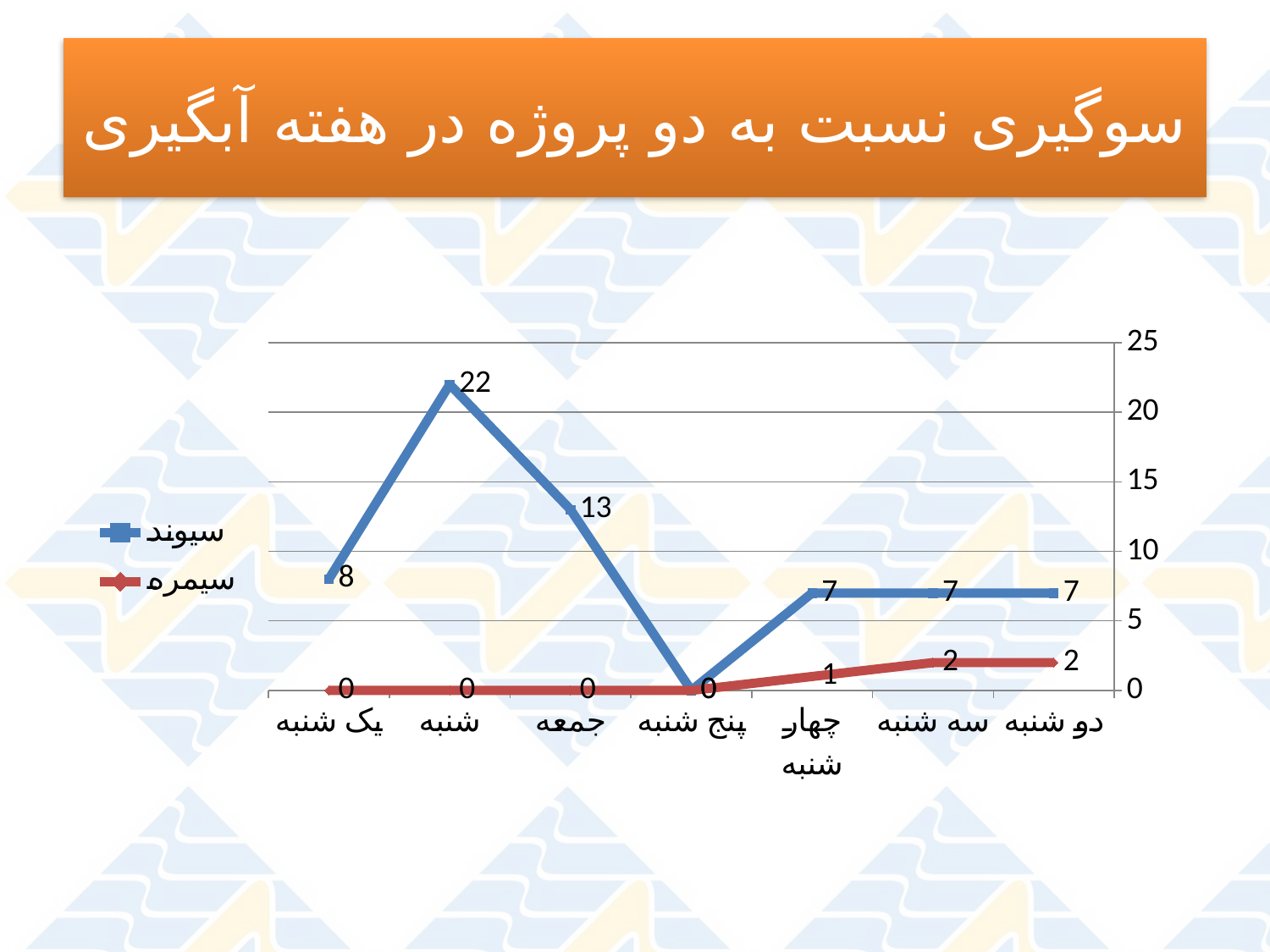
What is the difference between the سیوند values on شنبه and جمعه? 9 What is the value for سیوند on شنبه? 22 What is the value for سیوند on یک شنبه? 8 What kind of chart is shown on the slide? Line chart On which day does سیوند have its lowest value? پنج شنبه What is the value for سیوند on جمعه? 13 Which series has the larger value on چهار شنبه, سیوند or سیمره? سیوند On which day does سیوند reach its highest value? شنبه What is the value for سیمره on سه شنبه? 2 How many series does the legend list? 2 How many days are shown on the x axis? 7 What colour is the line for سیمره? Red